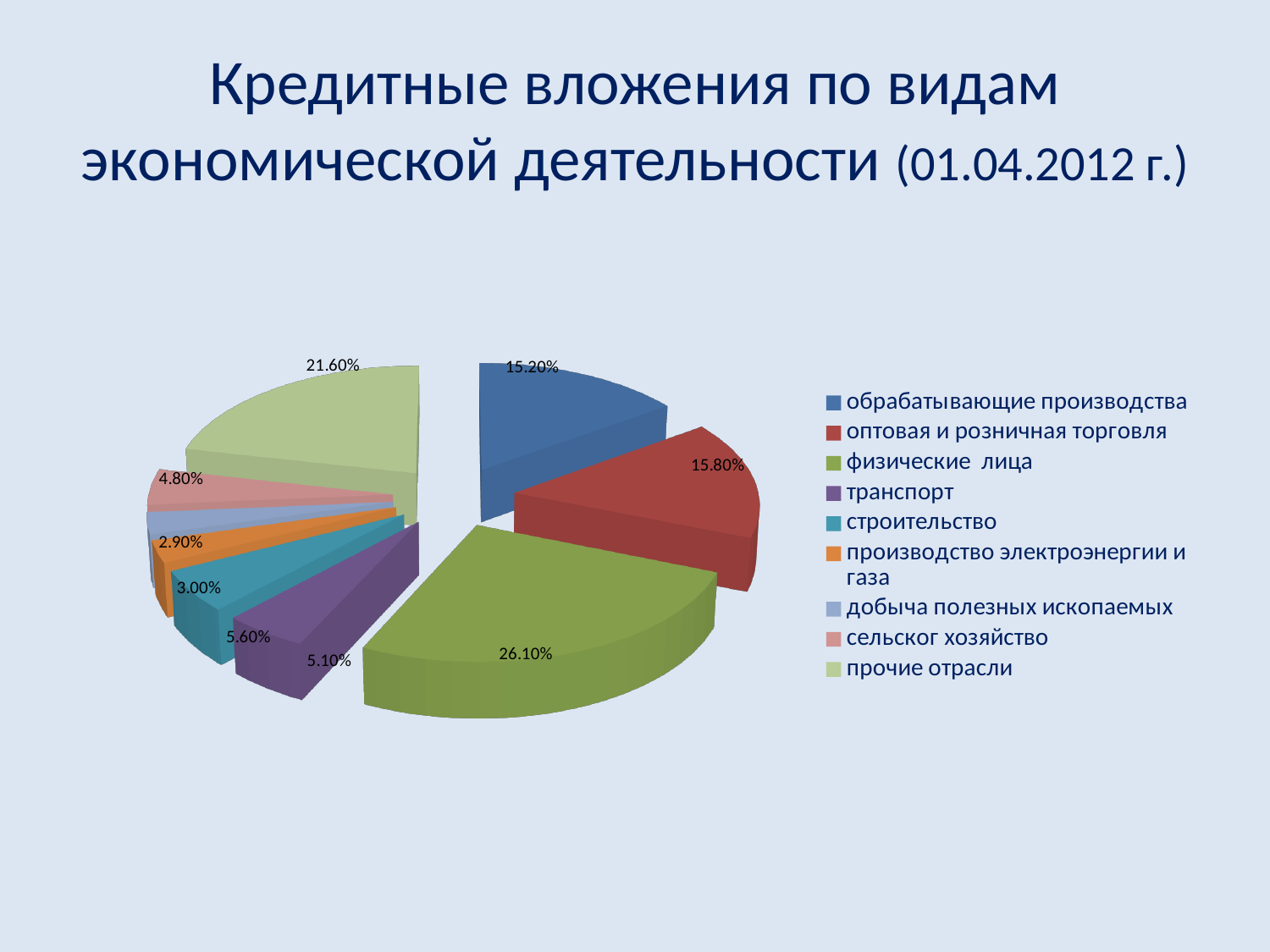
What is the value for прочие отрасли? 21.60% Which is larger: the share for транспорт or the share for строительство? строительство What is the date given in the slide title? 01.04.2012 г. What is the value for обрабатывающие производства? 15.20% Which category has the smallest share of the pie? добыча полезных ископаемых What is the value for оптовая и розничная торговля? 15.80% Which category has the largest share of the pie? физические лица What share of credit investments goes to физические лица? 26.10% What is the value for строительство? 5.60% How many categories does the legend list? 9 What kind of chart is shown on the slide? pie chart What is the difference between the shares of физические лица and прочие отрасли? 4.50%